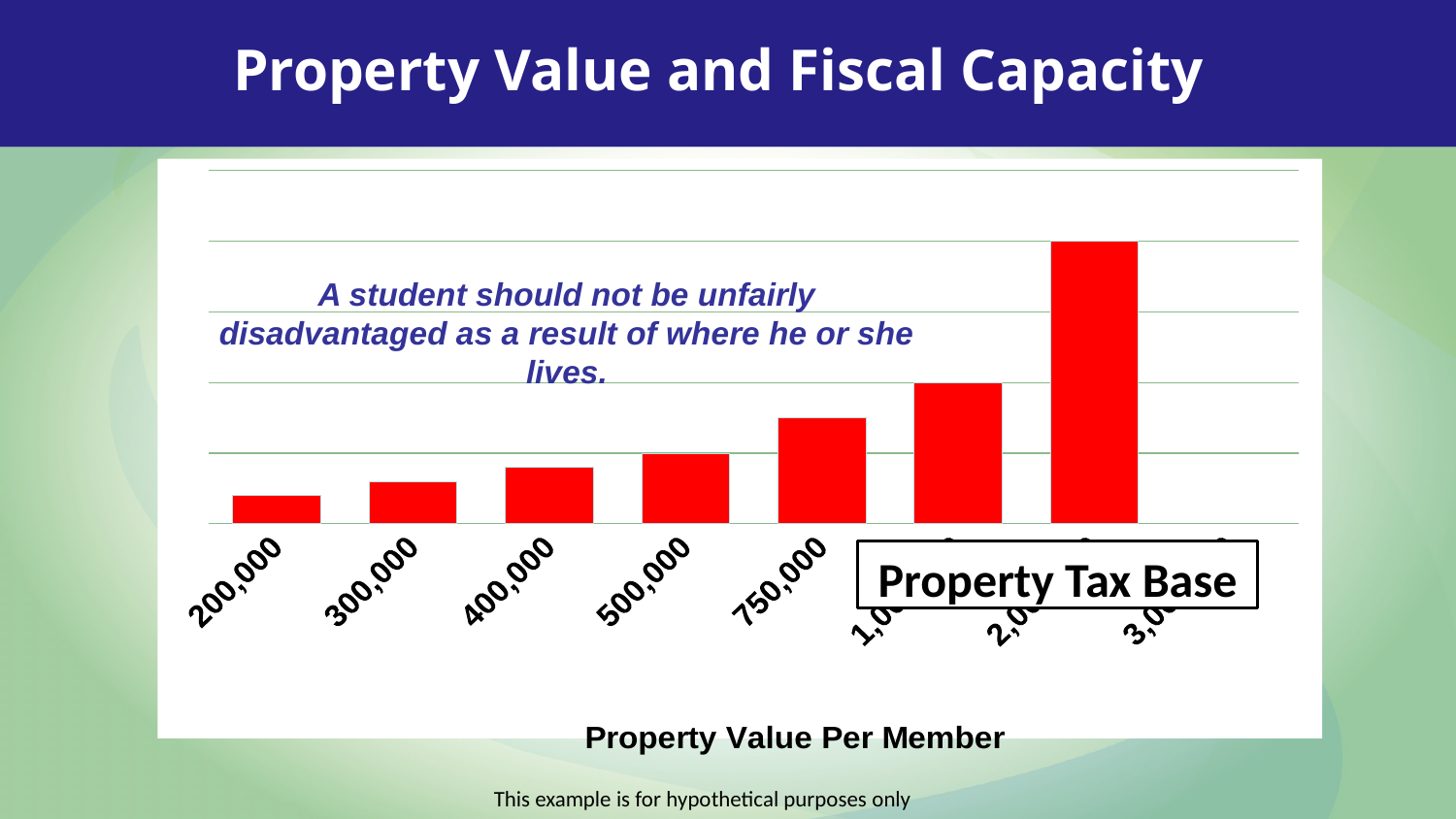
Which is larger, the bar for 200,000 or the bar for 300,000? 300,000 Do the bar values rise or fall as property value per member increases from 200,000 to 750,000? rise What kind of chart is shown on the slide? bar chart Which is larger, the bar for 300,000 or the bar for 500,000? 500,000 How many category labels are shown along the x axis of the chart? 8 Which is larger, the bar for 750,000 or the bar for 400,000? 750,000 What is the title of the x axis of the chart? Property Value Per Member What colour are the bars in the chart? red Which category has the lowest bar in the chart? 200,000